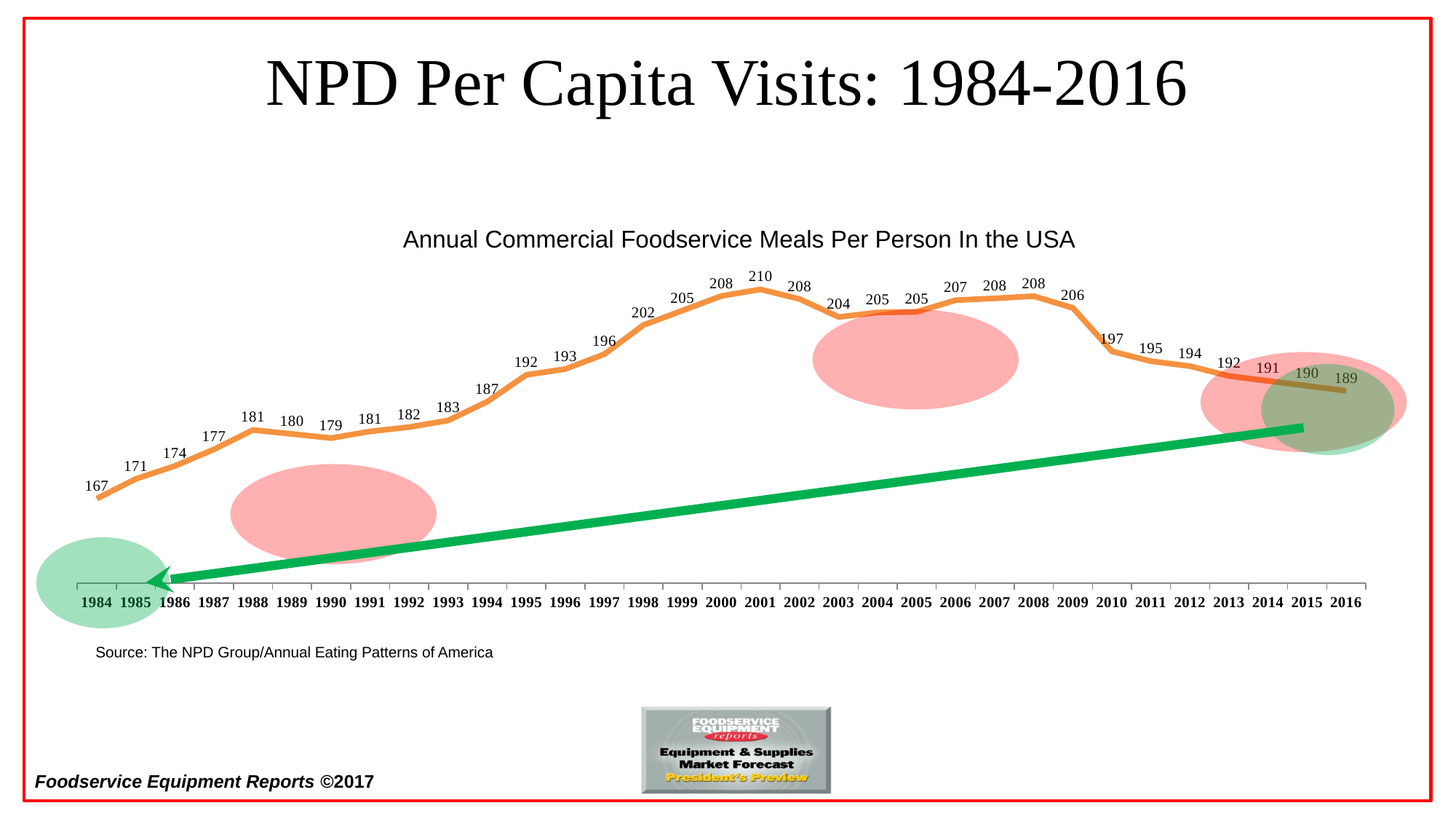
Which is larger, the value for 2000 or the value for 2010? 2000 What is the value for 2016? 189 What is the value for 1984? 167 What is the difference between the values for 2001 and 1984? 43 Which year has the lowest value? 1984 What is the value for 1998? 202 What kind of chart is this? line chart Which year has the highest value? 2001 Which is larger, the value for 1995 or the value for 2013? 1995 and 2013 are equal (192) What is the value for 2001? 210 How many years are plotted on the x axis? 33 What is the difference between the values for 2009 and 2010? 9